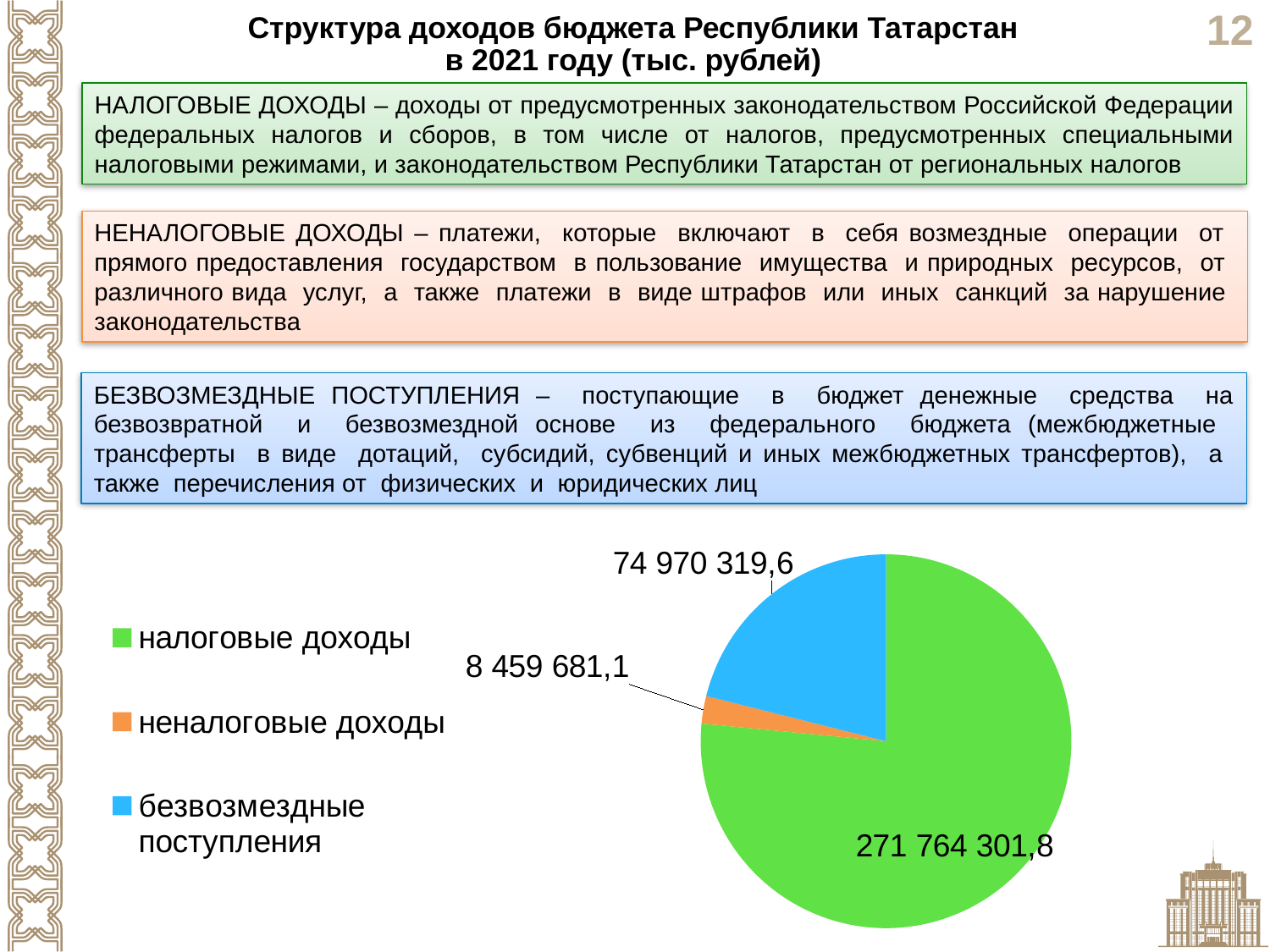
What is the difference between налоговые доходы and безвозмездные поступления? 196 793 982,2 What is the value for безвозмездные поступления in the pie chart? 74 970 319,6 How many slices does the pie chart have? 3 What is the value for неналоговые доходы in the pie chart? 8 459 681,1 What colour is the slice for безвозмездные поступления? blue What is the difference between безвозмездные поступления and неналоговые доходы? 66 510 638,5 Which is larger: безвозмездные поступления or неналоговые доходы? безвозмездные поступления Which category has the smallest slice in the pie chart? неналоговые доходы What is the total of all three slices in the pie chart? 355 194 302,5 What type of chart is shown on the slide? pie chart Which category has the largest slice in the pie chart? налоговые доходы What is the value for налоговые доходы in the pie chart? 271 764 301,8